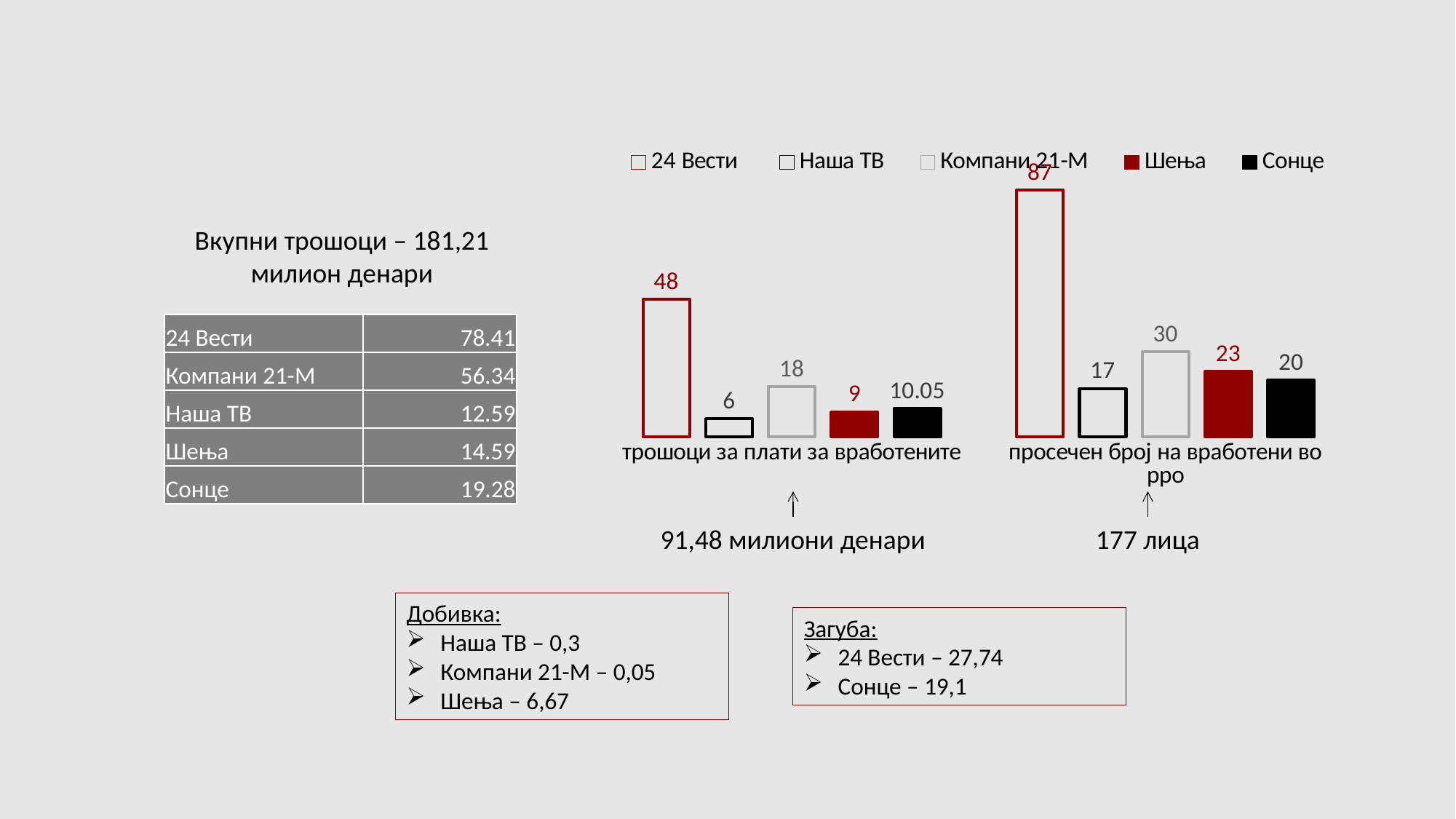
Which series has the lowest value in the category 'трошоци за плати за вработените'? Наша ТВ What is the value for Сонце in the category 'трошоци за плати за вработените'? 10.05 What is the value for Компани 21-М in the category 'просечен број на вработени во рро'? 30 What is the value for 24 Вести in the category 'трошоци за плати за вработените'? 48 Which series has the highest value in the category 'просечен број на вработени во рро'? 24 Вести What is the difference between the values for Шења and Сонце in the category 'просечен број на вработени во рро'? 3 Which series is drawn with a solid dark red fill in the chart? Шења How many series does the chart legend list? 5 How many categories are shown on the x axis of the chart? 2 What kind of chart is shown on the slide? bar chart What is the difference between the values for 24 Вести and Наша ТВ in the category 'просечен број на вработени во рро'? 70 In the category 'трошоци за плати за вработените', which is larger: the value for Компани 21-М or the value for Шења? Компани 21-М